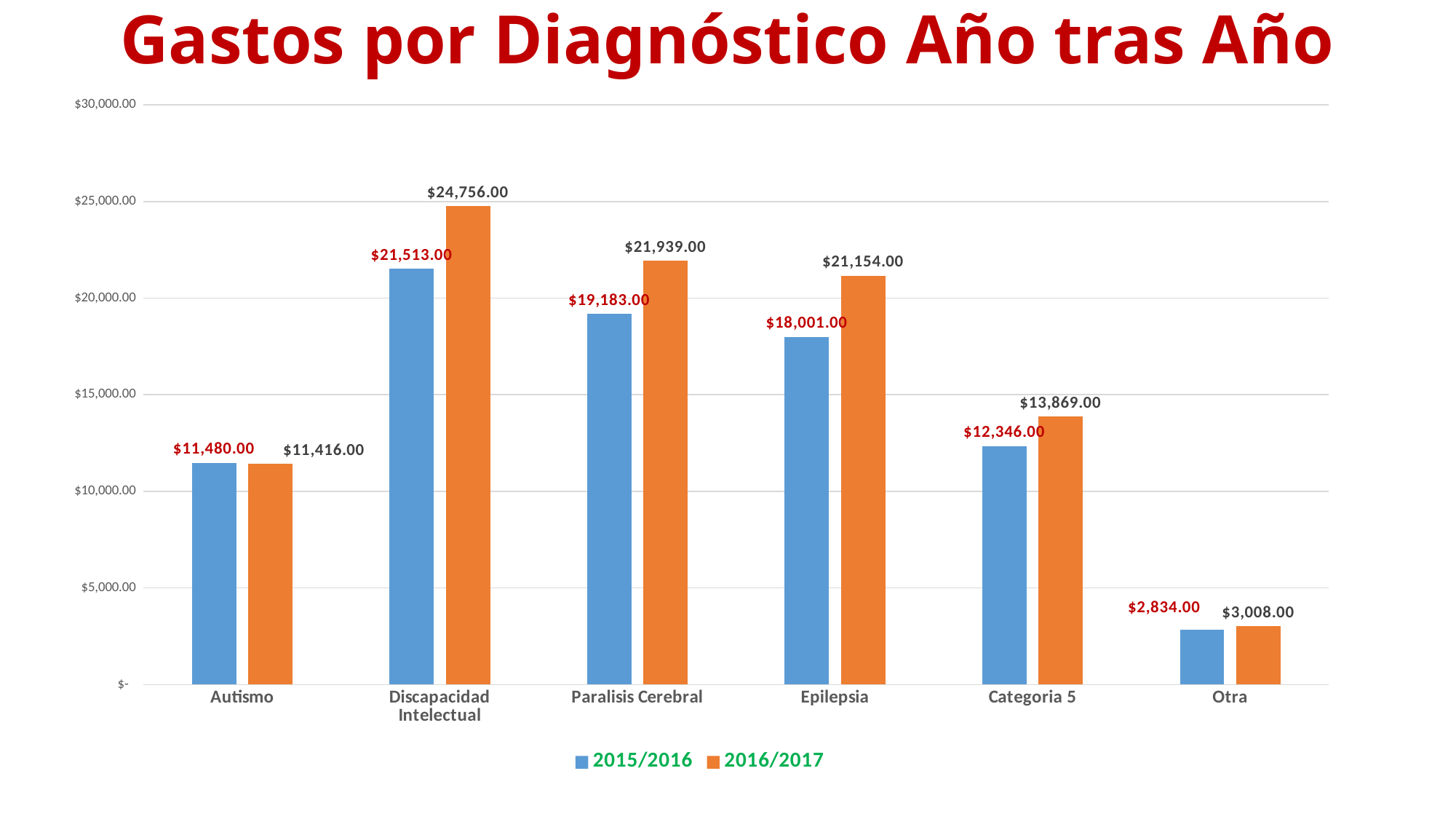
What is the 2016/2017 value for Discapacidad Intelectual? $24,756.00 Which category has the lowest 2015/2016 value? Otra What is the 2016/2017 value for Otra? $3,008.00 How many categories are shown on the x axis? 6 Which is larger for Autismo: the 2015/2016 value or the 2016/2017 value? 2015/2016 What kind of chart is shown on the slide? Bar chart What is the 2015/2016 value for Autismo? $11,480.00 What is the 2015/2016 value for Epilepsia? $18,001.00 How many series does the legend list? 2 Which category has the highest 2016/2017 value? Discapacidad Intelectual What is the title of the chart? Gastos por Diagnóstico Año tras Año What is the difference between the 2016/2017 and 2015/2016 values for Paralisis Cerebral? $2,756.00